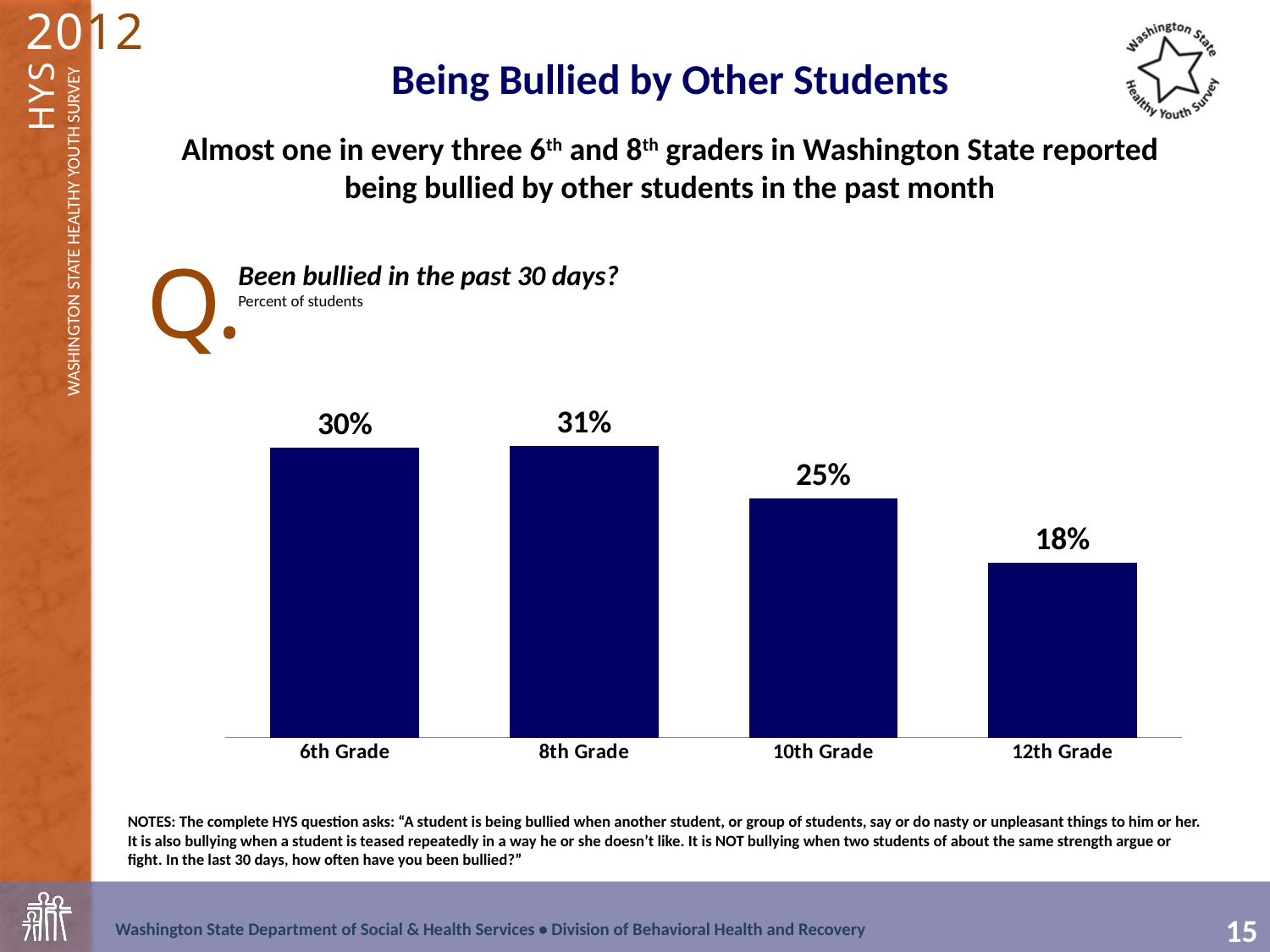
Which grade has the lowest percent of students reporting being bullied? 12th Grade What kind of chart is shown on the slide? Bar chart How many grade categories are shown in the chart? 4 What is the difference in percentage points between 6th Grade and 10th Grade? 5 What percent of 8th graders reported being bullied in the past 30 days? 31% What percent of 6th graders reported being bullied in the past 30 days? 30% Which is larger, the value for 10th Grade or the value for 12th Grade? 10th Grade What percent of 10th graders reported being bullied in the past 30 days? 25% From 8th Grade to 12th Grade, do the values rise or fall? Fall What percent of 12th graders reported being bullied in the past 30 days? 18% Which grade has the highest percent of students reporting being bullied? 8th Grade What is the difference in percentage points between 8th Grade and 12th Grade? 13